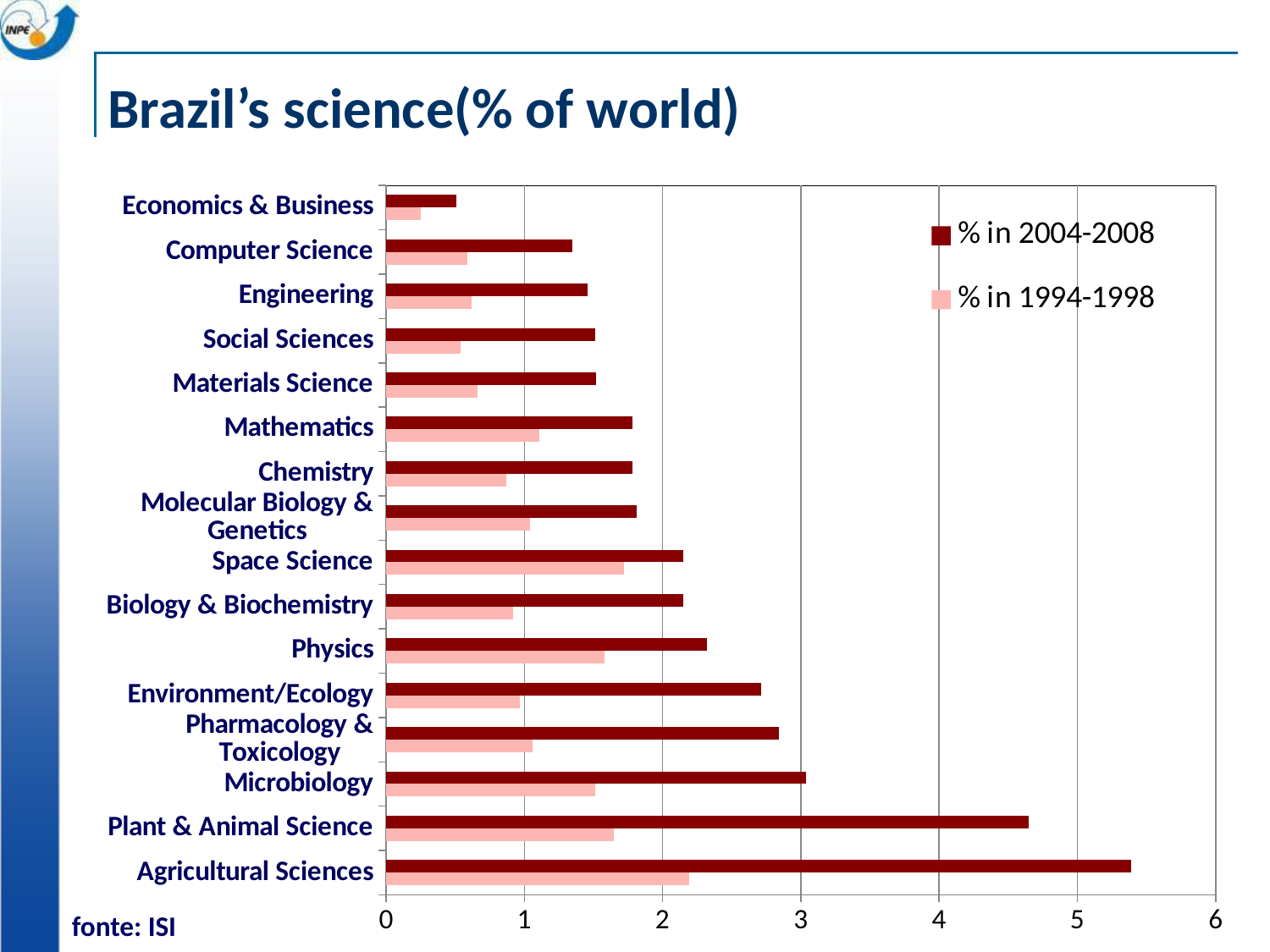
What kind of chart is shown on the slide? bar chart Which field has the lowest value for % in 2004-2008? Economics & Business What are the two series named in the legend? % in 2004-2008 and % in 1994-1998 Which is larger for % in 1994-1998: Space Science or Biology & Biochemistry? Space Science How many series does the legend list? 2 Which is larger for % in 2004-2008: Environment/Ecology or Physics? Environment/Ecology Which field has the highest value for % in 1994-1998? Agricultural Sciences Is the value for Agricultural Sciences in 2004-2008 greater or less than 5? greater Is the value for Computer Science in 1994-1998 greater or less than 1? less Is the value for Plant & Animal Science in 2004-2008 greater or less than 4? greater Which field has the highest value for % in 2004-2008? Agricultural Sciences How many categories (fields of science) are plotted on the chart? 16